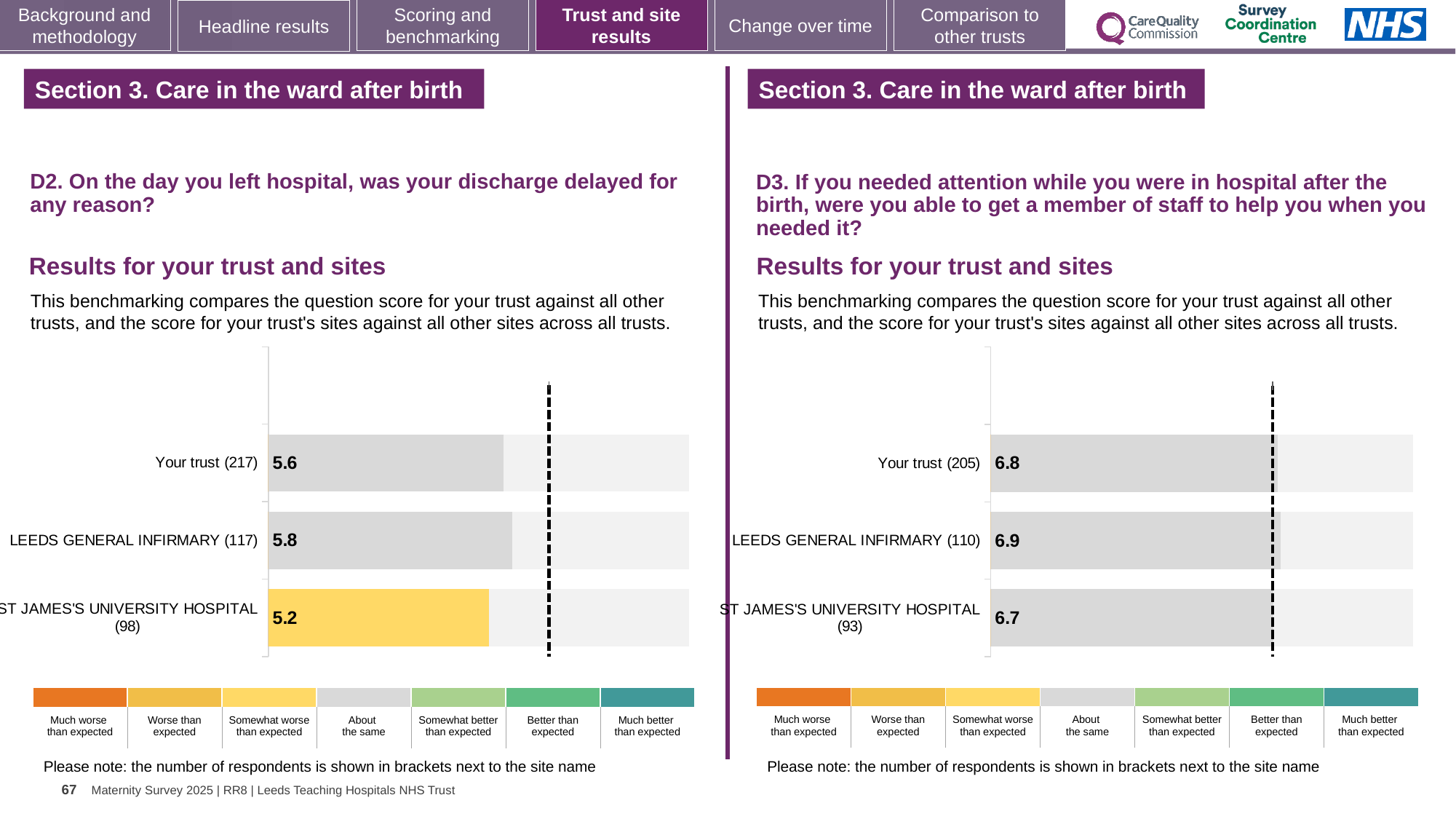
On the left chart (D2, discharge delayed), what is the score for Your trust? 5.6 On the left chart (D2, discharge delayed), how many bars are plotted? 3 On the left chart (D2, discharge delayed), how many respondents are shown in brackets for Your trust? 217 On the left chart (D2, discharge delayed), what is the score for St James's University Hospital? 5.2 What kind of chart is shown on the left side of the slide (D2)? Bar chart On the right chart (D3, able to get staff to help), what is the difference between the Leeds General Infirmary score and the St James's University Hospital score? 0.2 On the left chart (D2, discharge delayed), which site or trust has the lowest score? St James's University Hospital On the right chart (D3, able to get staff to help), what is the score for Leeds General Infirmary? 6.9 On the left chart (D2, discharge delayed), what is the difference between the Leeds General Infirmary score and the St James's University Hospital score? 0.6 On the left chart (D2, discharge delayed), what is the score for Leeds General Infirmary? 5.8 On the right chart (D3, able to get staff to help), what is the score for St James's University Hospital? 6.7 On the right chart (D3, able to get staff to help), what is the score for Your trust? 6.8